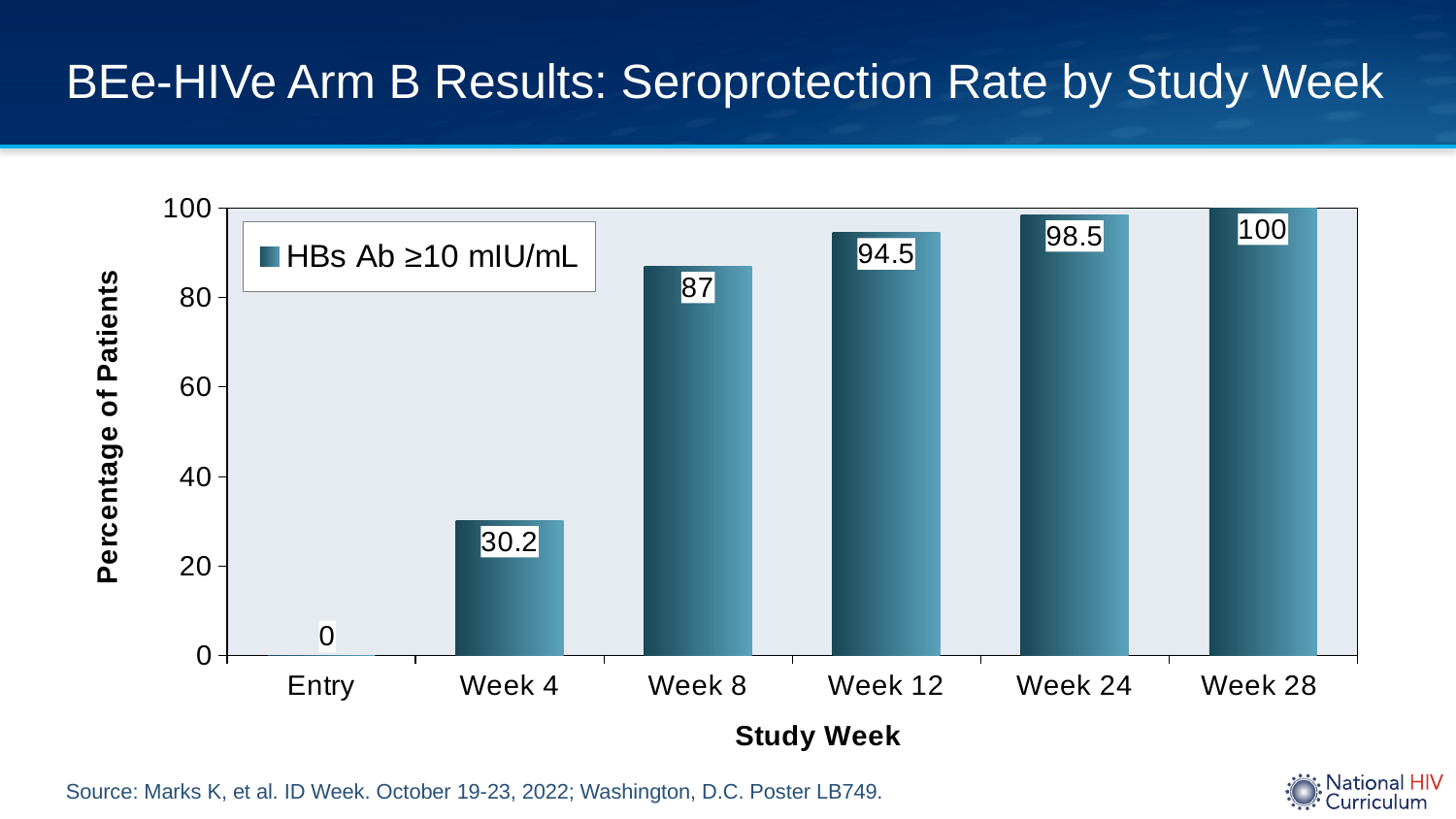
Do the values rise or fall from Entry to Week 28? Rise What is the difference between the values at Week 28 and Week 24? 1.5 What is the percentage of patients with HBs Ab ≥10 mIU/mL at Week 4? 30.2 How many series does the legend list? 1 Which is larger, the value at Week 12 or the value at Week 8? Week 12 What is the value shown for Entry? 0 How many study week categories are shown on the x axis? 6 Which study week has the highest percentage of patients? Week 28 What kind of chart is shown on the slide? Bar chart Which study week has the lowest percentage of patients? Entry What is the difference between the values at Week 8 and Week 4? 56.8 What is the percentage of patients with HBs Ab ≥10 mIU/mL at Week 12? 94.5